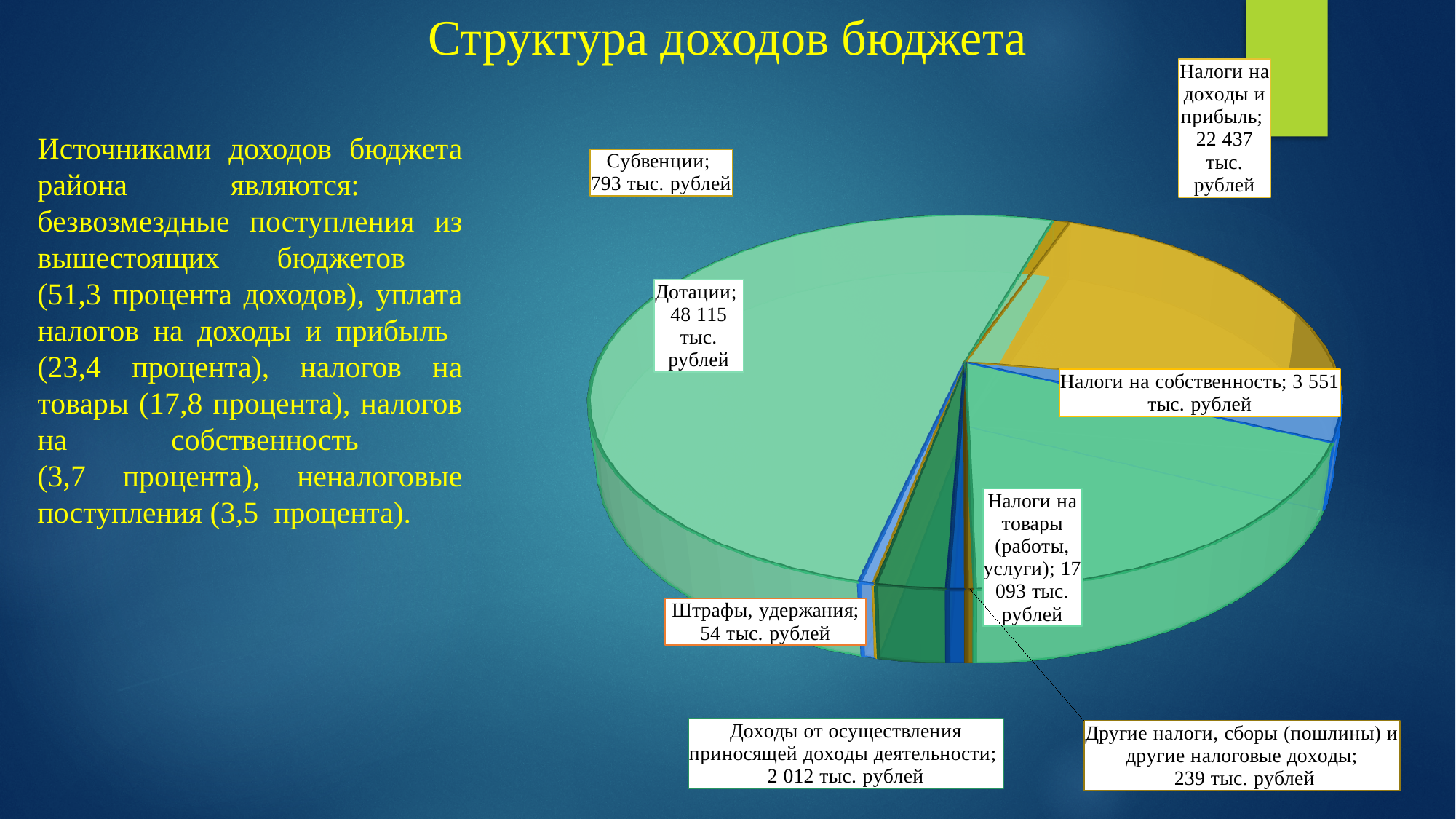
Which category has the largest value in the pie chart? Дотации What is the value for Доходы от осуществления приносящей доходы деятельности? 2 012 тыс. рублей What is the value for Дотации? 48 115 тыс. рублей What is the title of the slide's chart? Структура доходов бюджета How many categories does the pie chart show? 10 What is the difference between Дотации and Налоги на доходы и прибыль? 25 678 тыс. рублей Which is larger: Налоги на товары (работы, услуги) or Налоги на собственность? Налоги на товары (работы, услуги) What kind of chart is shown on the slide? Pie chart Which category has the smallest value in the pie chart? Штрафы, удержания What is the value for Налоги на доходы и прибыль? 22 437 тыс. рублей What is the difference between Субвенции and Другие налоги, сборы (пошлины) и другие налоговые доходы? 554 тыс. рублей What is the value for Штрафы, удержания? 54 тыс. рублей